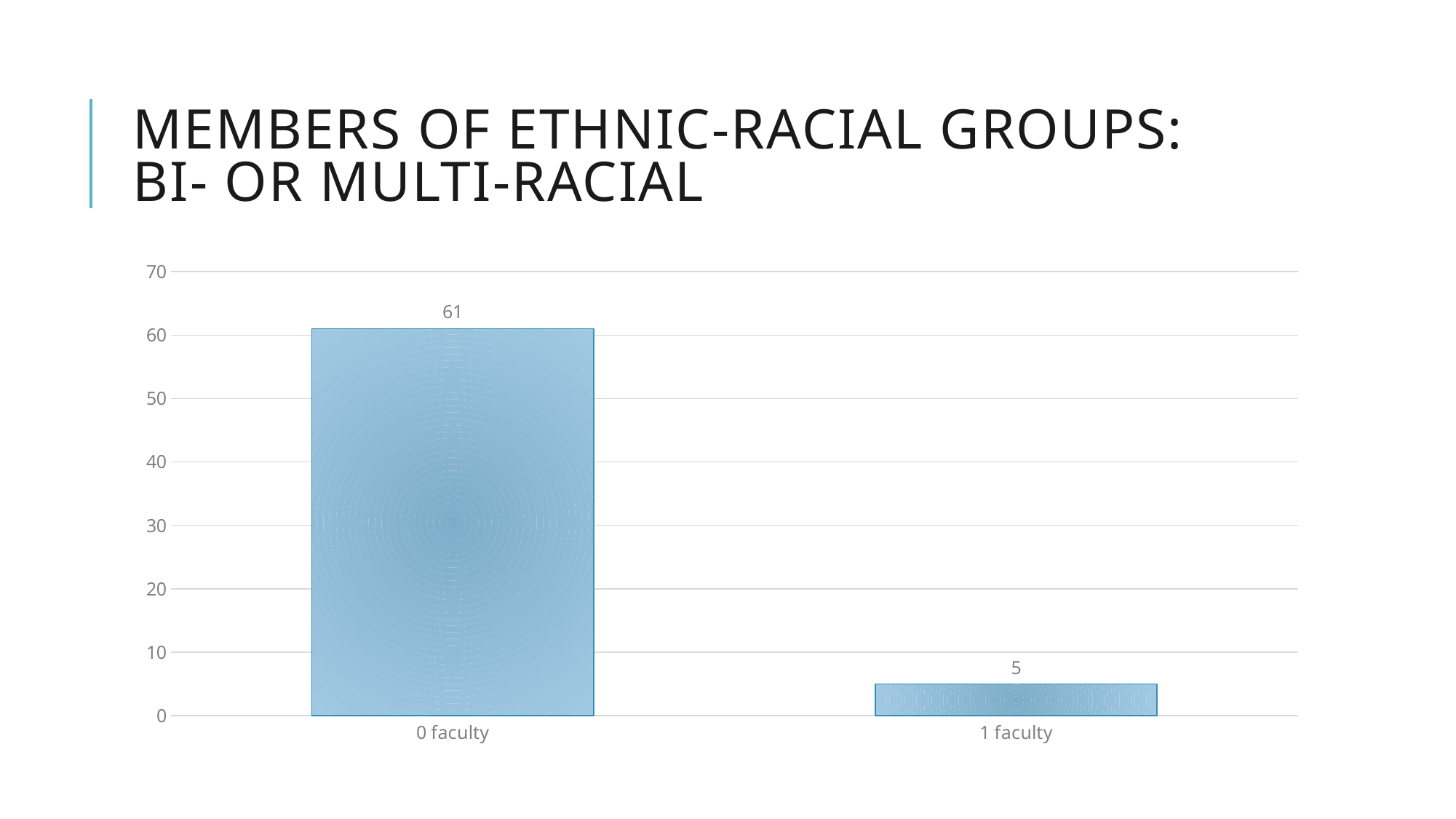
Do the values rise or fall from left to right along the x axis? fall Is the value for "0 faculty" greater or less than 50? greater What is the title of the slide? Members of Ethnic-Racial Groups: Bi- or Multi-Racial Which category has the lowest value? 1 faculty How many categories are shown on the x axis? 2 Which is larger, the value for "0 faculty" or the value for "1 faculty"? 0 faculty What is the value for the "0 faculty" category? 61 Is the value for "1 faculty" greater or less than 10? less Which category has the highest value? 0 faculty What kind of chart is shown on the slide? bar chart What is the difference between the values for "0 faculty" and "1 faculty"? 56 What is the value for the "1 faculty" category? 5